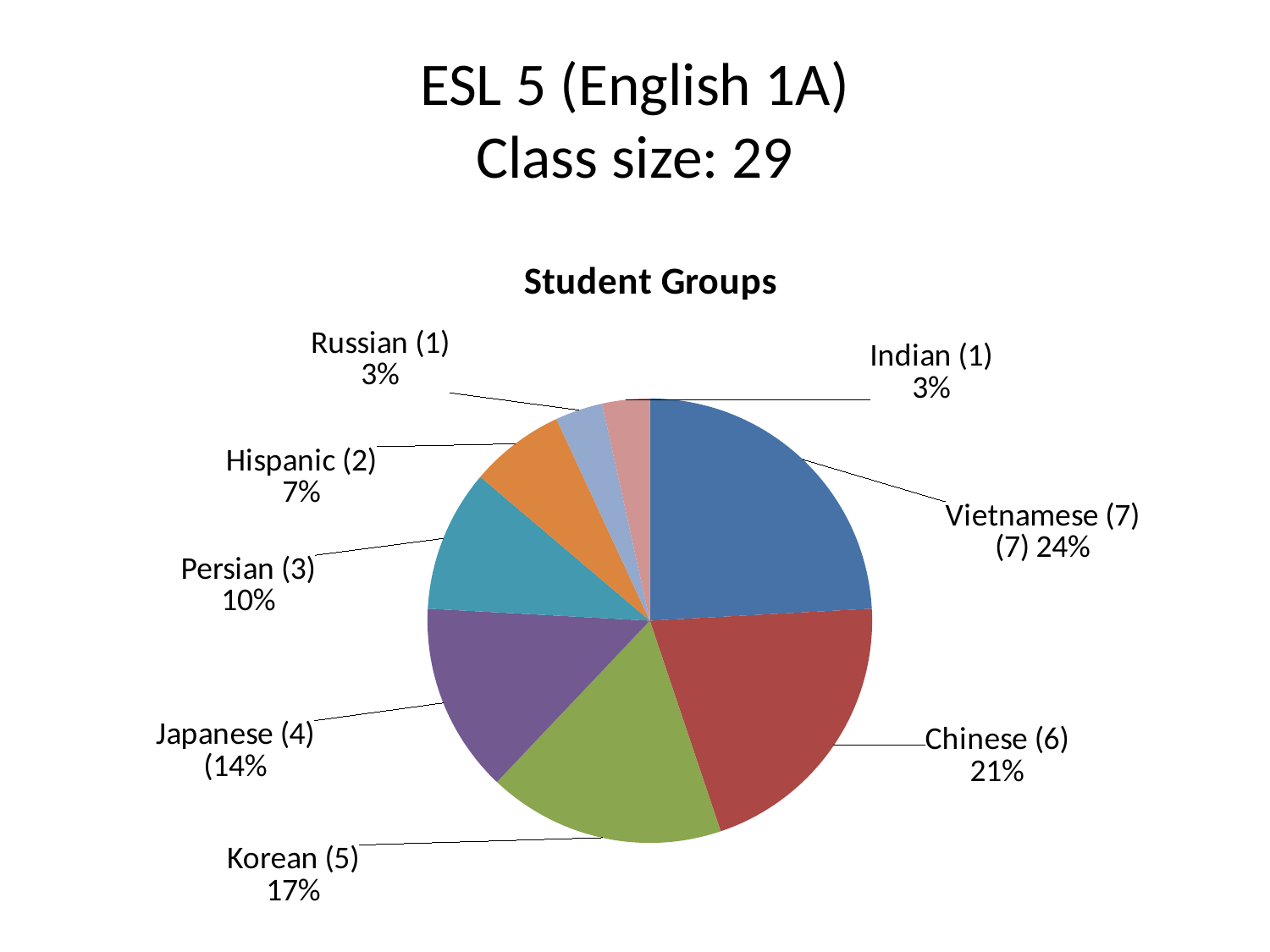
What percentage of the Student Groups pie chart is Persian? 10% Which student group has the smallest share, Hispanic or Persian? Hispanic What is the title of the chart on the slide? Student Groups What is the difference in percentage points between the Chinese and Korean slices? 4 What percentage of the Student Groups pie chart is Vietnamese? 24% How many students are in the Japanese group according to the chart label? 4 What is the class size stated in the slide title? 29 What type of chart is used to show the Student Groups? Pie chart How many student groups are shown in the pie chart? 8 What percentage of the Student Groups pie chart is Chinese? 21% What percentage of the Student Groups pie chart is Korean? 17% Which student group has the largest slice of the pie chart? Vietnamese